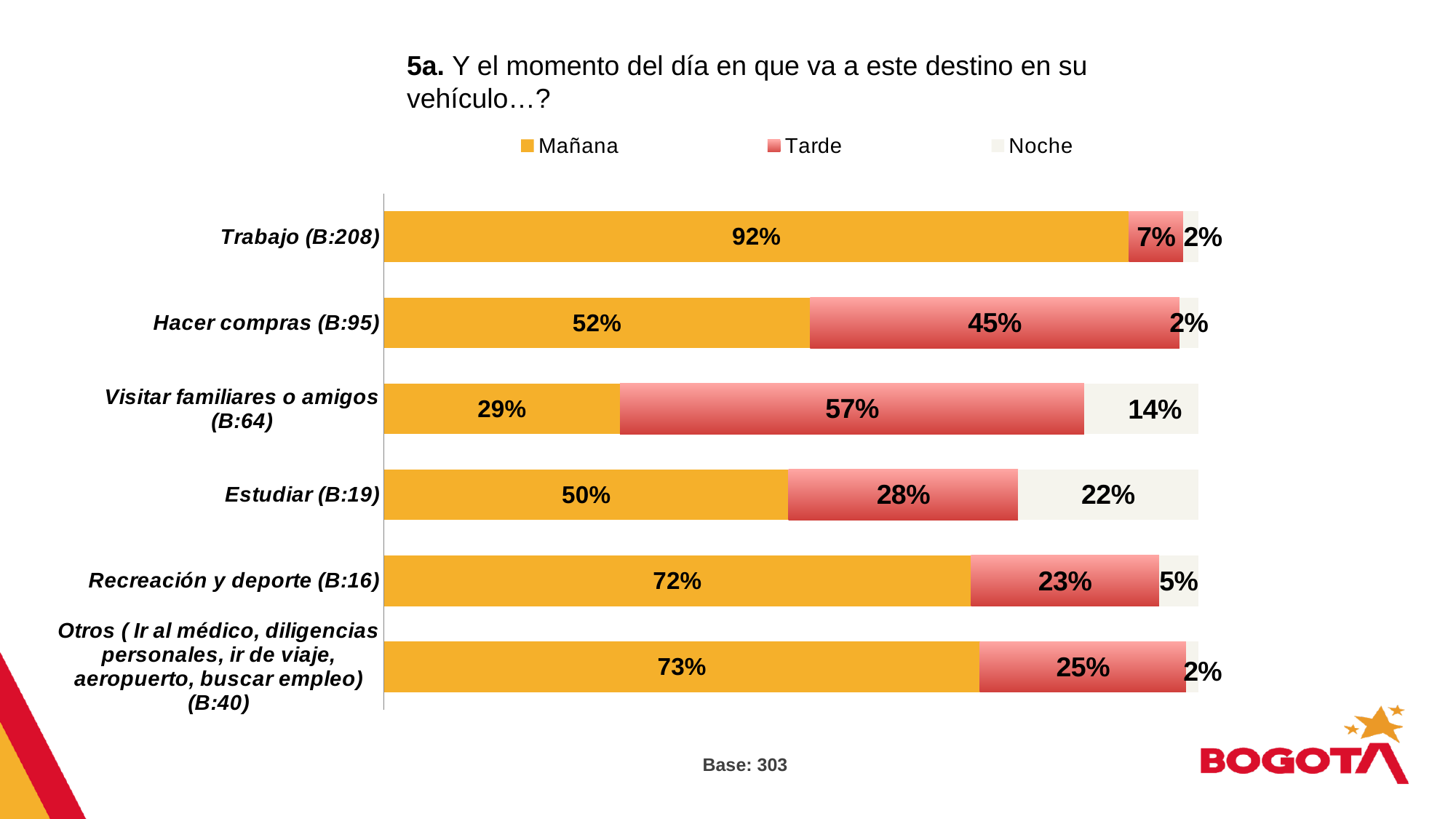
What is the Noche value for Estudiar (B:19)? 22% What is the Tarde value for Visitar familiares o amigos (B:64)? 57% Which category has the lowest Mañana value? Visitar familiares o amigos (B:64) What is the Tarde value for Hacer compras (B:95)? 45% What is the Mañana value for Trabajo (B:208)? 92% Which is larger: the Tarde value for Hacer compras (B:95) or the Tarde value for Estudiar (B:19)? Hacer compras (B:95) How many categories are shown on the chart? 6 What is the difference between the Mañana values for Recreación y deporte (B:16) and Estudiar (B:19)? 22% How many series does the legend list? 3 What is the base shown below the chart? Base: 303 What kind of chart is shown on the slide? Stacked bar chart Which category has the highest Mañana value? Trabajo (B:208)